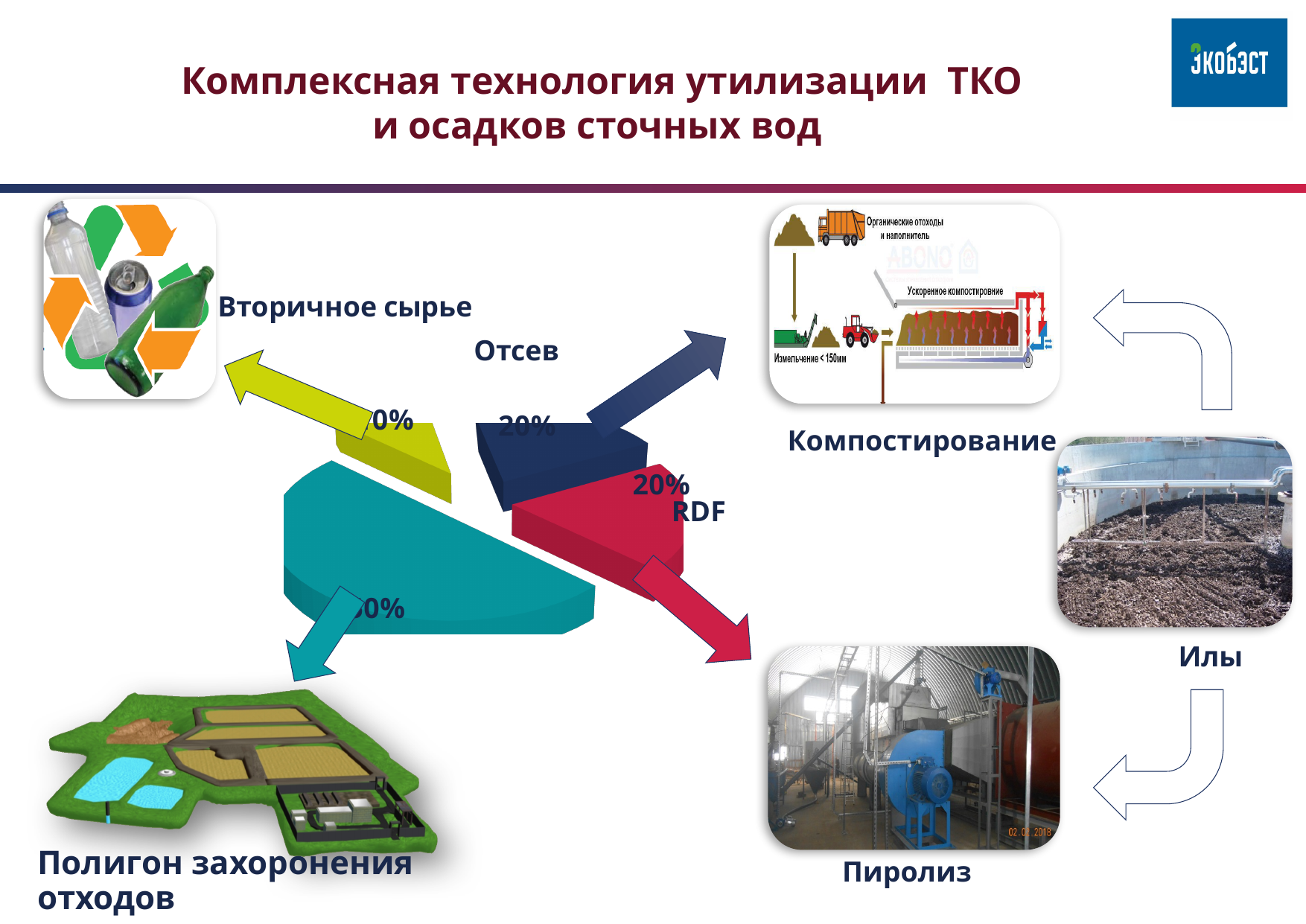
What is the difference between the Отсев share and the RDF share? 0% What colour is the slice labelled RDF? red What percentage is shown for the Отсев slice? 20% Which slice of the pie chart is the largest? Полигон захоронения отходов What share of the pie does the RDF slice represent? 20% What percentage is shown for the RDF slice? 20% Which is larger: the slice for Отсев or the slice for Вторичное сырье? Отсев Which slice of the pie chart is the smallest? Вторичное сырье Which is larger: the slice for Полигон захоронения отходов or the slice for RDF? Полигон захоронения отходов What colour is the slice for Полигон захоронения отходов? teal What kind of chart is shown on the slide? pie chart How many slices does the pie chart have? 4